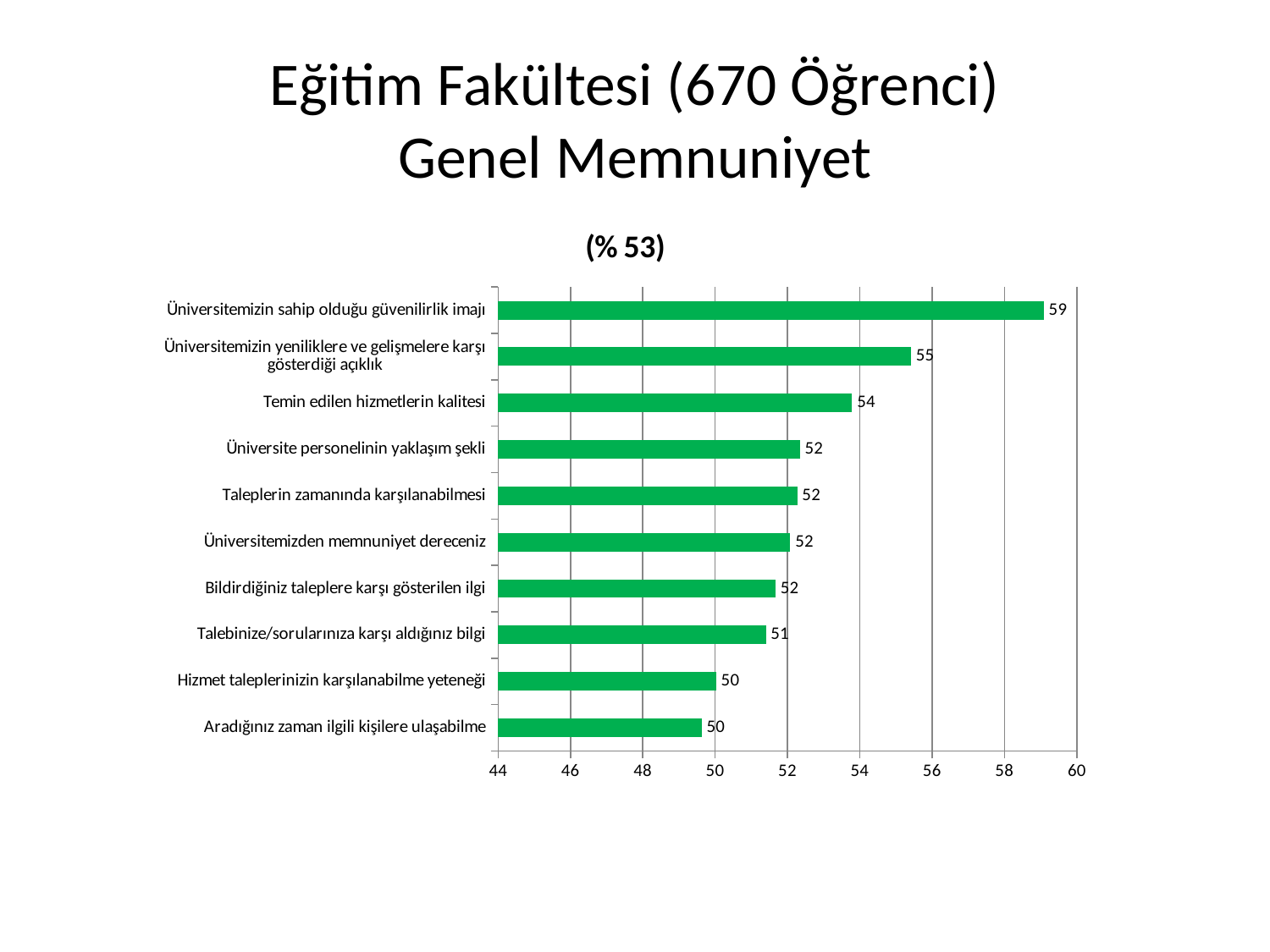
Which category has the highest value? Üniversitemizin sahip olduğu güvenilirlik imajı How many categories are shown in the chart? 10 What is the value for "Temin edilen hizmetlerin kalitesi"? 54 What is the value for "Üniversitemizin yeniliklere ve gelişmelere karşı gösterdiği açıklık"? 55 What is the difference between the values for "Üniversitemizin yeniliklere ve gelişmelere karşı gösterdiği açıklık" and "Temin edilen hizmetlerin kalitesi"? 1 What is the value for "Talebinize/sorularınıza karşı aldığınız bilgi"? 51 What is the difference between the values for "Üniversitemizin sahip olduğu güvenilirlik imajı" and "Aradığınız zaman ilgili kişilere ulaşabilme"? 9 Is the value for "Üniversitemizin sahip olduğu güvenilirlik imajı" greater or less than 56? greater Which is larger, the value for "Temin edilen hizmetlerin kalitesi" or the value for "Hizmet taleplerinizin karşılanabilme yeteneği"? Temin edilen hizmetlerin kalitesi What kind of chart is shown on the slide? bar chart What is the value for "Üniversitemizin sahip olduğu güvenilirlik imajı"? 59 What is the title of the chart? (% 53)